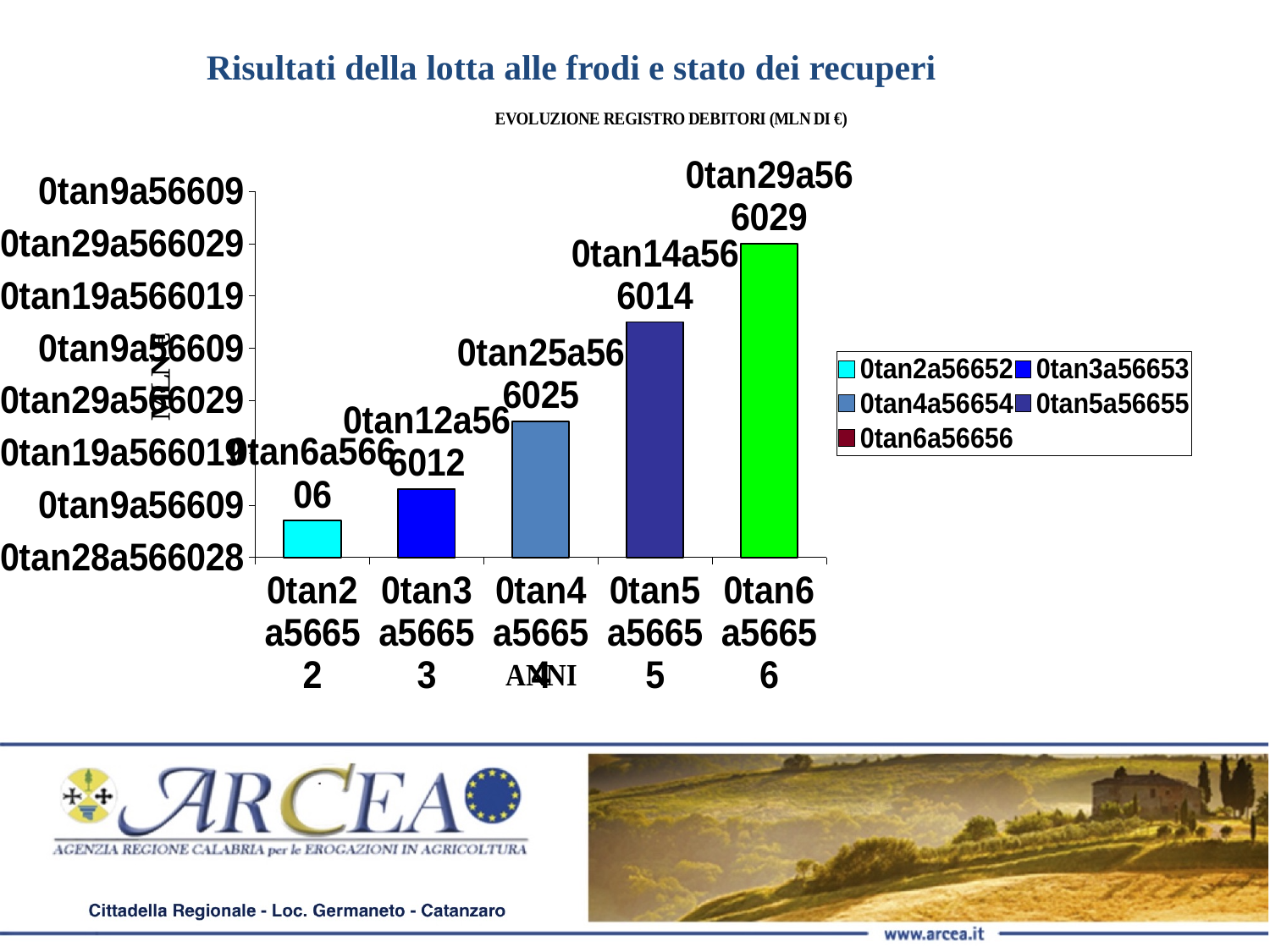
What is the label of the x axis of the chart? ANNI Which category has the tallest bar in the chart? 0tan6a56656 Which bar is taller, the one for 0tan3a56653 or the one for 0tan5a56655? 0tan5a56655 Which bar is taller, the one for 0tan4a56654 or the one for 0tan2a56652? 0tan4a56654 What is the title of the chart? EVOLUZIONE REGISTRO DEBITORI (MLN DI €) What kind of chart is shown on the slide? bar chart Which category has the shortest bar in the chart? 0tan2a56652 How many bars are plotted in the chart? 5 How many entries does the chart legend list? 5 Do the bar heights rise or fall from left to right along the x axis? rise